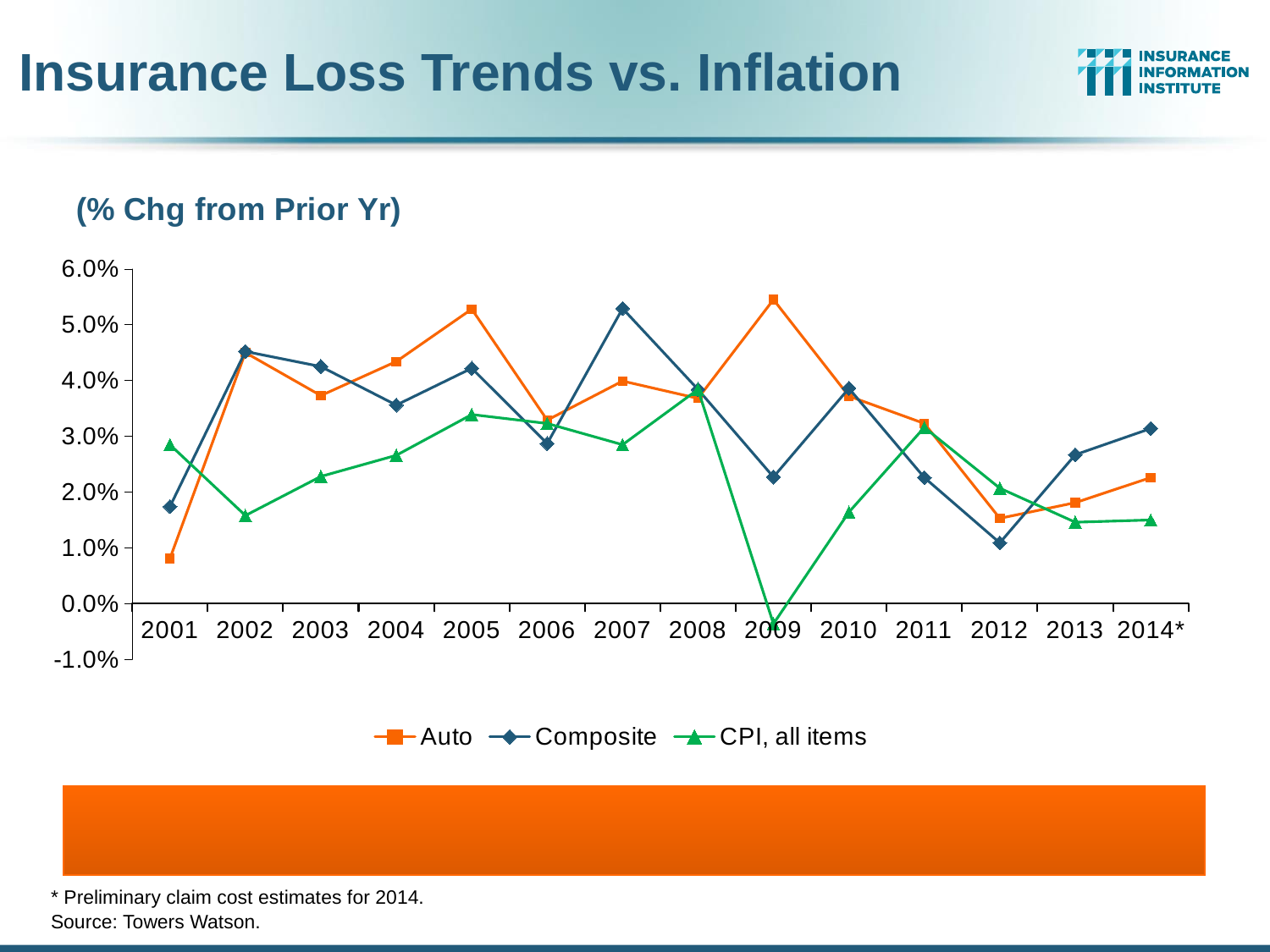
Does the Auto series rise or fall from 2009 to 2012? Fall In which year does the Composite series reach its highest value? 2007 What kind of chart is shown on the slide? Line chart In which year is the CPI, all items series at its lowest? 2009 How many years are plotted along the x axis? 14 How many series does the legend list? 3 Is the value for Auto in 2001 greater or less than 1.0%? less In which year is the Composite series at its lowest? 2012 Is the value for Auto in 2014* greater or less than 3.0%? less Is the value for CPI, all items in 2009 greater or less than 0.0%? less In 2009, which is larger: Auto or Composite? Auto In 2007, which is larger: Auto or Composite? Composite